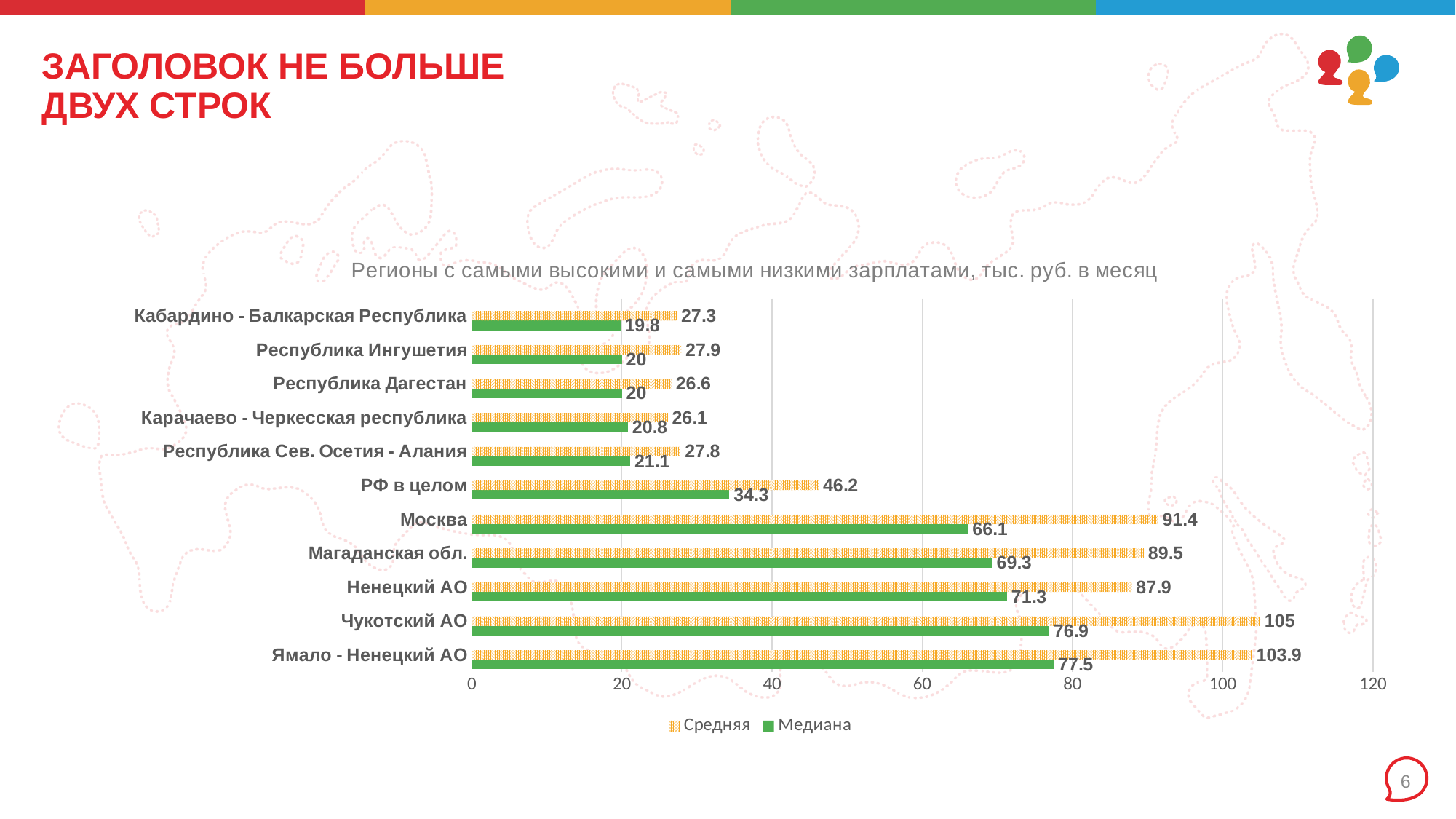
What is the title of the chart? Регионы с самыми высокими и самыми низкими зарплатами, тыс. руб. в месяц How many series does the legend list? 2 Which region has the highest Средняя value? Чукотский АО How many regions (categories) are shown in the chart? 11 What is the Средняя value for Республика Дагестан? 26.6 Which is larger: the Медиана value for Магаданская обл. or the Медиана value for Ненецкий АО? Ненецкий АО What type of chart is shown on the slide? bar chart What is the Медиана value for РФ в целом? 34.3 What is the difference between the Средняя and Медиана values for Ямало - Ненецкий АО? 26.4 Which region has the lowest Медиана value? Кабардино - Балкарская Республика Is the Средняя value for РФ в целом greater or less than 40? greater What is the Средняя value for Москва? 91.4